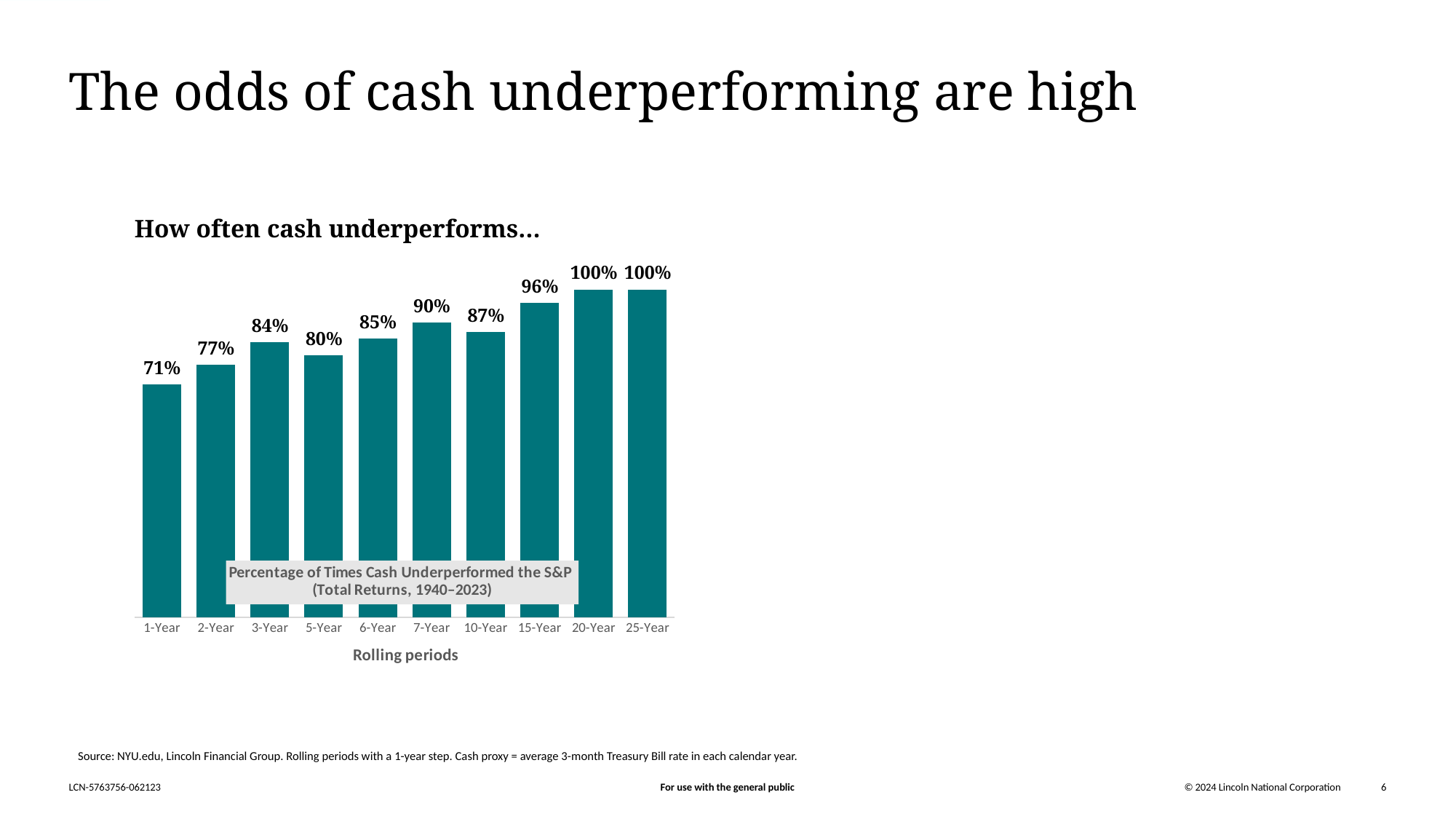
What is the highest percentage shown on the chart? 100% What is the title of the chart? Percentage of Times Cash Underperformed the S&P (Total Returns, 1940–2023) Which rolling period has the lowest percentage? 1-Year Which is larger, the value for 3-Year or the value for 5-Year? 3-Year What is the value for the 15-Year rolling period? 96% What kind of chart is shown on the slide? Bar chart Do the values generally rise or fall from 1-Year to 25-Year? Rise What is the label of the x axis? Rolling periods What is the difference between the 10-Year and 5-Year values? 7% How many rolling periods are shown on the chart? 10 What is the value for the 7-Year rolling period? 90% What is the value for the 1-Year rolling period? 71%